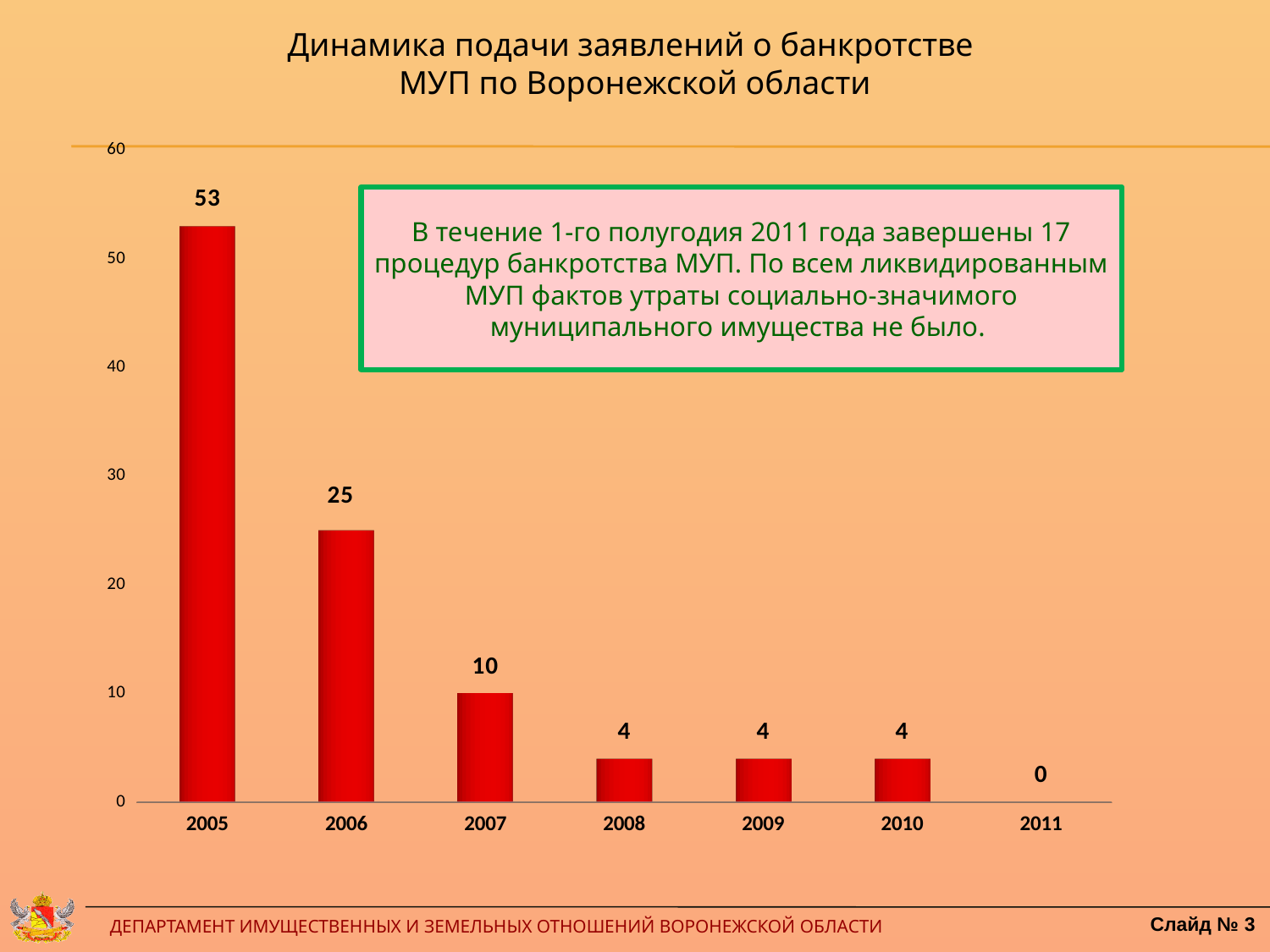
What is the value for 2005? 53 Do the values rise or fall from 2005 to 2011? fall What is the difference between the values for 2005 and 2006? 28 What is the value for 2007? 10 Which year has the lowest value? 2011 Which is larger, the value for 2007 or the value for 2008? 2007 How many years are shown on the x axis? 7 What is the value for 2006? 25 What kind of chart is shown on the slide? bar chart What is the value for 2011? 0 Is the value for 2005 greater or less than 50? greater Which year has the highest value? 2005